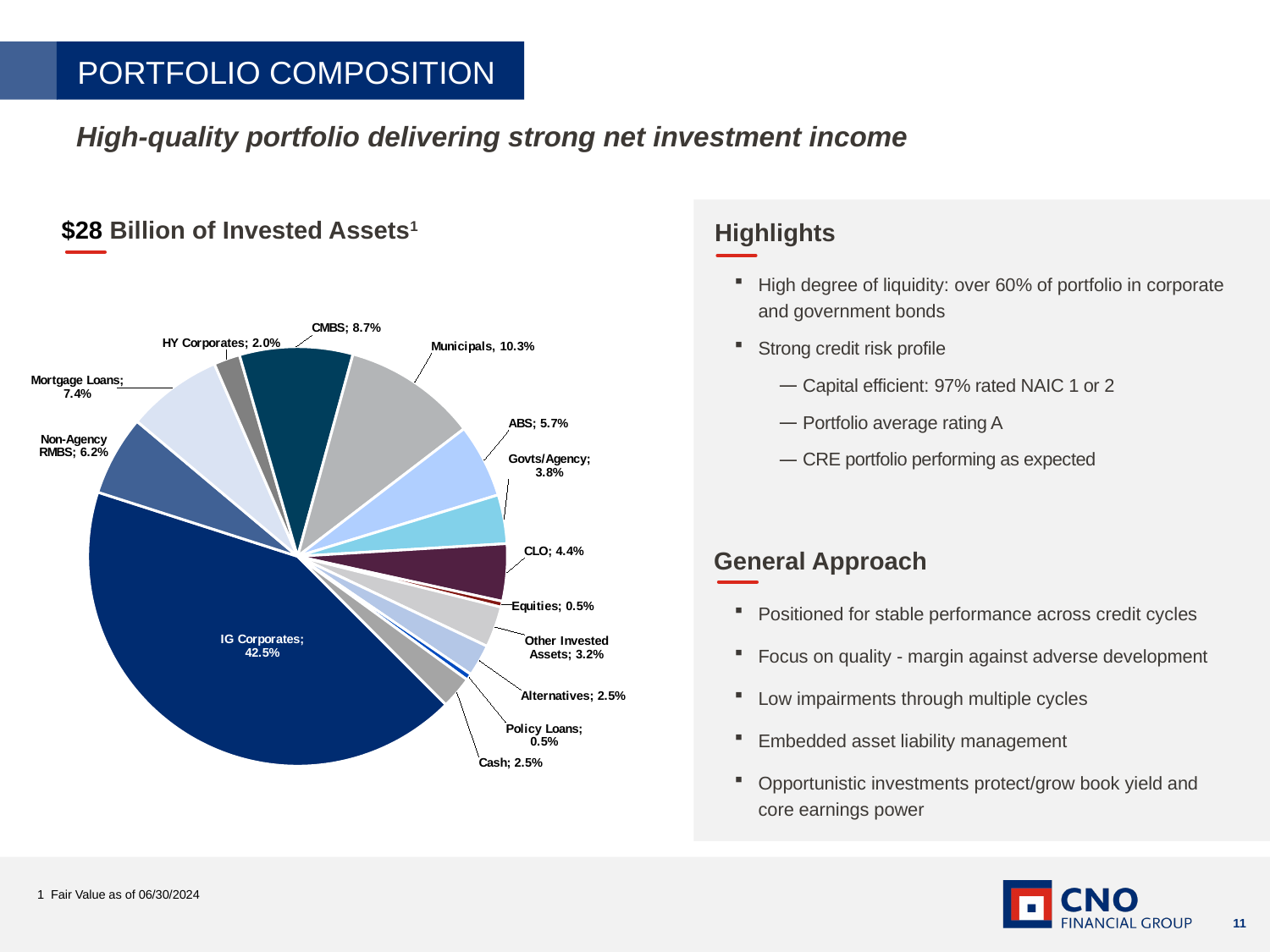
What share of invested assets is in Non-Agency RMBS? 6.2% Which category has a larger share, Mortgage Loans or ABS? Mortgage Loans How many categories are shown in the pie chart? 14 What is the difference in share between Municipals and CMBS? 1.6% What share of invested assets is in IG Corporates? 42.5% What is the combined share of Cash and Alternatives? 5.0% What share of invested assets is in CMBS? 8.7% What share of invested assets is in Govts/Agency? 3.8% What kind of chart is shown on the slide? Pie chart Which category has the largest share of invested assets? IG Corporates What share of invested assets is in Municipals? 10.3% What is the title of the pie chart? $28 Billion of Invested Assets